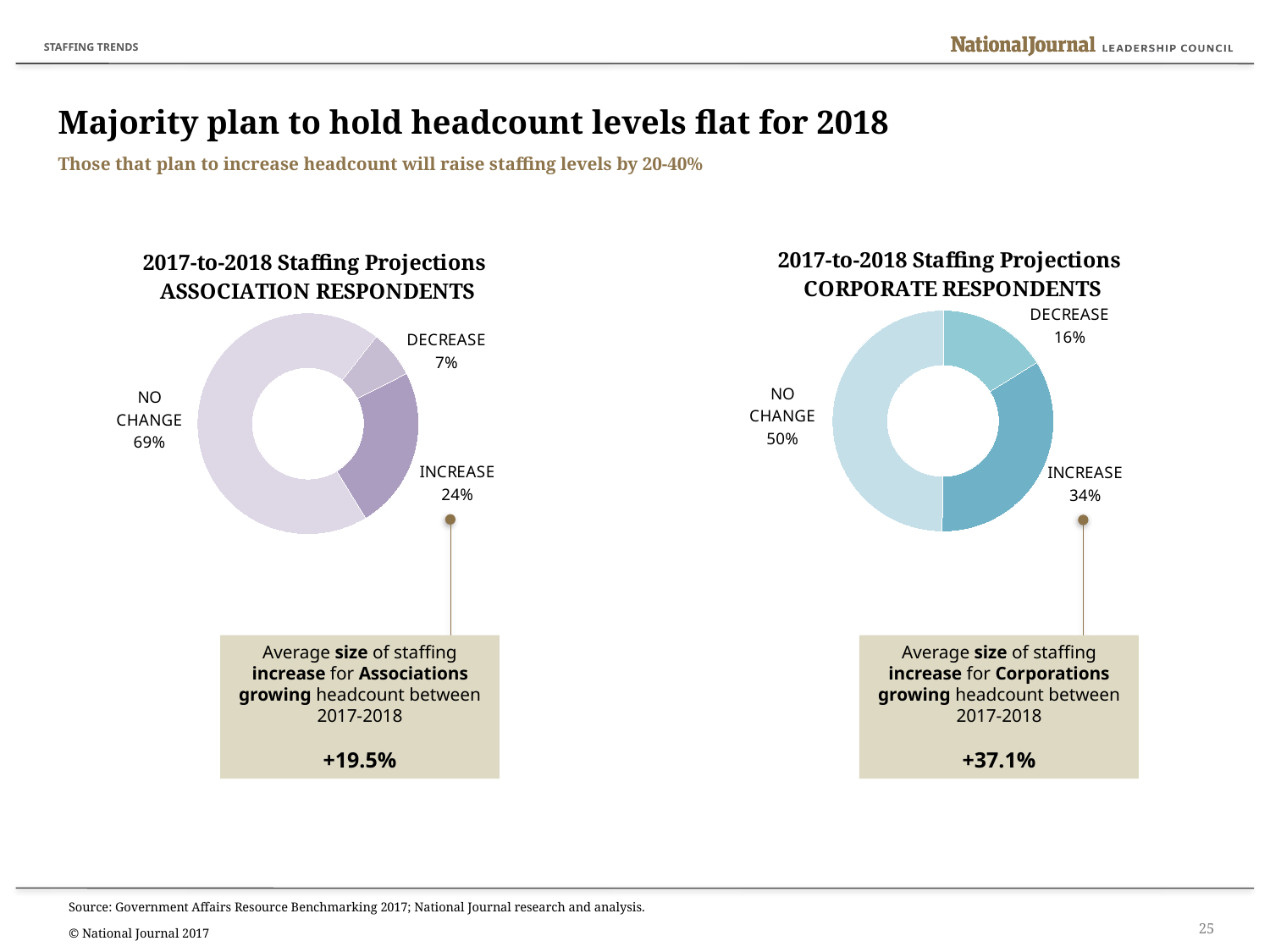
In the Corporate Respondents chart, what share of respondents plan to increase headcount? 34% What is the title of the left chart? 2017-to-2018 Staffing Projections ASSOCIATION RESPONDENTS Which is larger: the Increase share for Association respondents or the Increase share for Corporate respondents? Corporate respondents In the Association Respondents chart, which category has the smallest share? Decrease In the Association Respondents chart, what share of respondents plan to decrease headcount? 7% In the Association Respondents chart, what share of respondents plan no change in headcount? 69% In the Association Respondents chart, what is the combined share of respondents planning to increase or decrease headcount? 31% In the Corporate Respondents chart, what is the difference between the No Change share and the Increase share? 16 percentage points What is the average size of staffing increase for Corporations growing headcount between 2017-2018? +37.1% How many categories does the Association Respondents chart show? 3 In the Corporate Respondents chart, which category has the largest share? No change What type of chart is used for the Corporate Respondents data? Donut (pie) chart